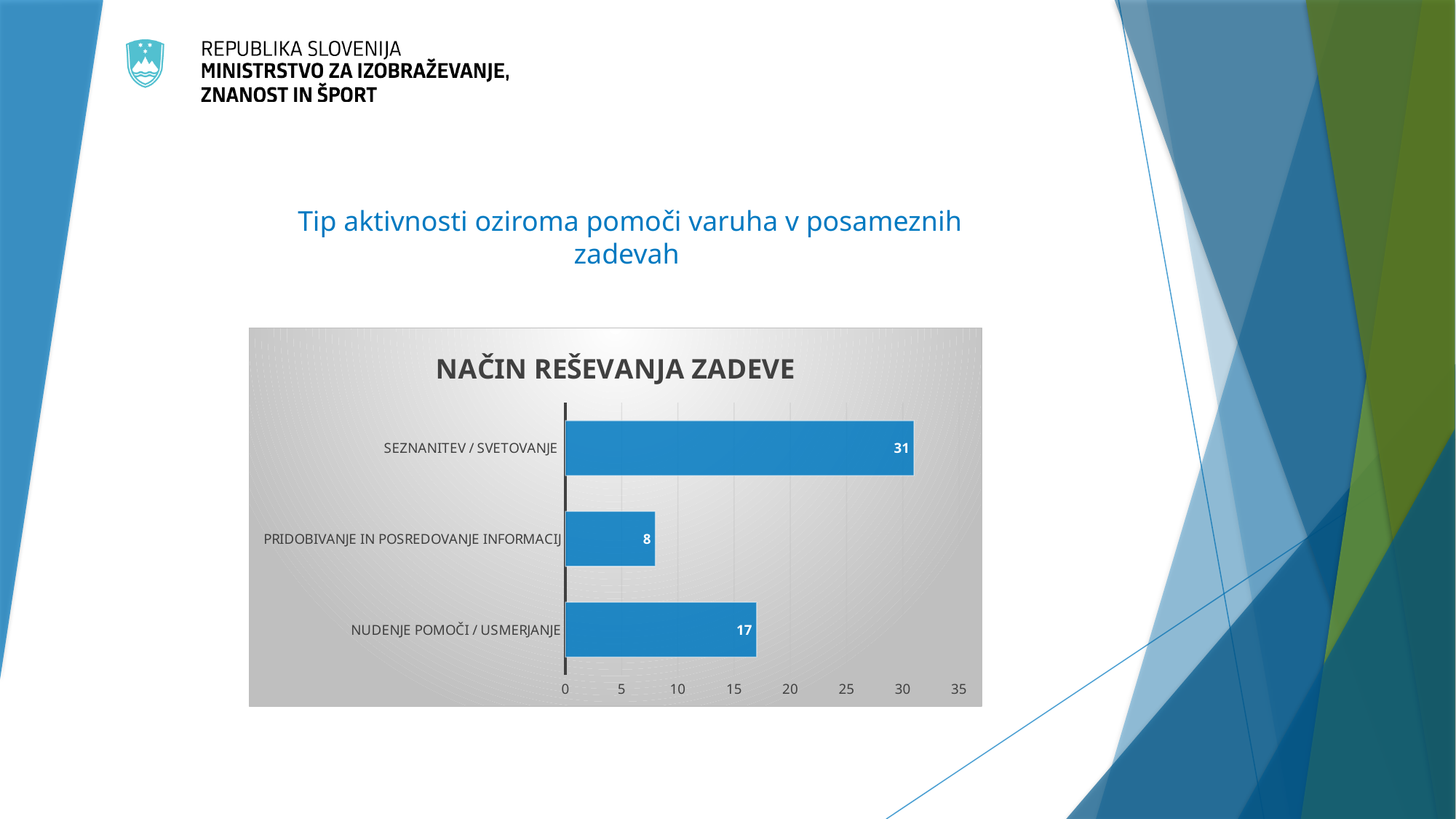
What is the difference between the values for SEZNANITEV / SVETOVANJE and NUDENJE POMOČI / USMERJANJE? 14 What is the difference between the values for NUDENJE POMOČI / USMERJANJE and PRIDOBIVANJE IN POSREDOVANJE INFORMACIJ? 9 Which category has the highest value? SEZNANITEV / SVETOVANJE How many categories are shown in the chart? 3 Which is larger, the value for NUDENJE POMOČI / USMERJANJE or the value for PRIDOBIVANJE IN POSREDOVANJE INFORMACIJ? NUDENJE POMOČI / USMERJANJE What is the title of the chart? NAČIN REŠEVANJA ZADEVE What is the value for SEZNANITEV / SVETOVANJE? 31 What kind of chart is shown on the slide? bar chart What is the value for NUDENJE POMOČI / USMERJANJE? 17 Is the value for SEZNANITEV / SVETOVANJE greater or less than 30? greater Which category has the lowest value? PRIDOBIVANJE IN POSREDOVANJE INFORMACIJ What is the value for PRIDOBIVANJE IN POSREDOVANJE INFORMACIJ? 8